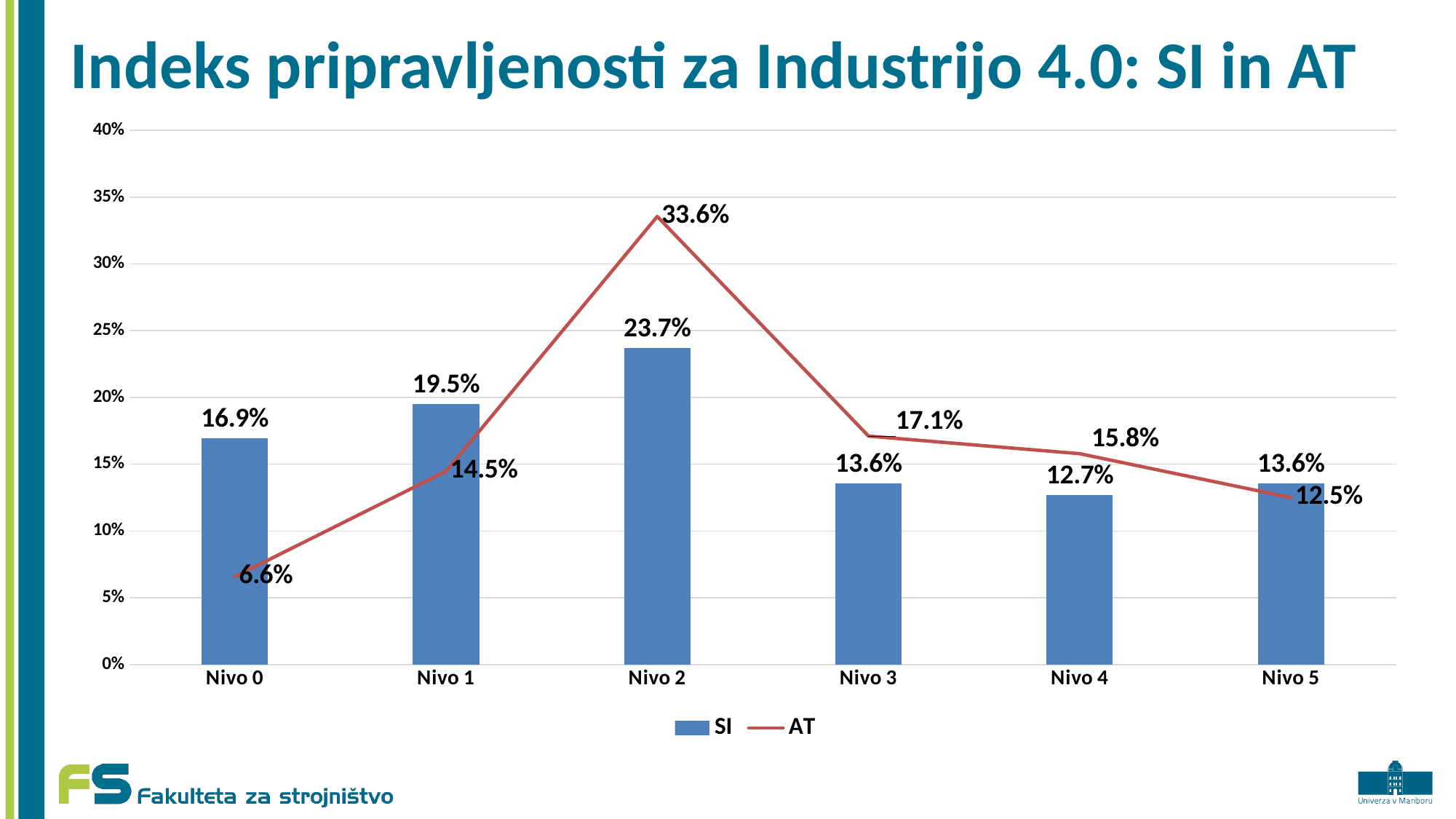
What is the SI value for Nivo 2? 23.7% Which level (Nivo) has the lowest SI value? Nivo 4 For Nivo 0, which series has the larger value, SI or AT? SI Which level (Nivo) has the highest AT value? Nivo 2 What is the AT value for Nivo 0? 6.6% What is the AT value for Nivo 4? 15.8% What kind of chart is used for the SI series? bar chart How many levels (categories) are shown on the x axis? 6 Is the AT value for Nivo 2 greater or less than 30%? greater How many series does the legend list? 2 What is the difference between the AT and SI values for Nivo 2? 9.9% What is the difference between the SI values for Nivo 1 and Nivo 0? 2.6%